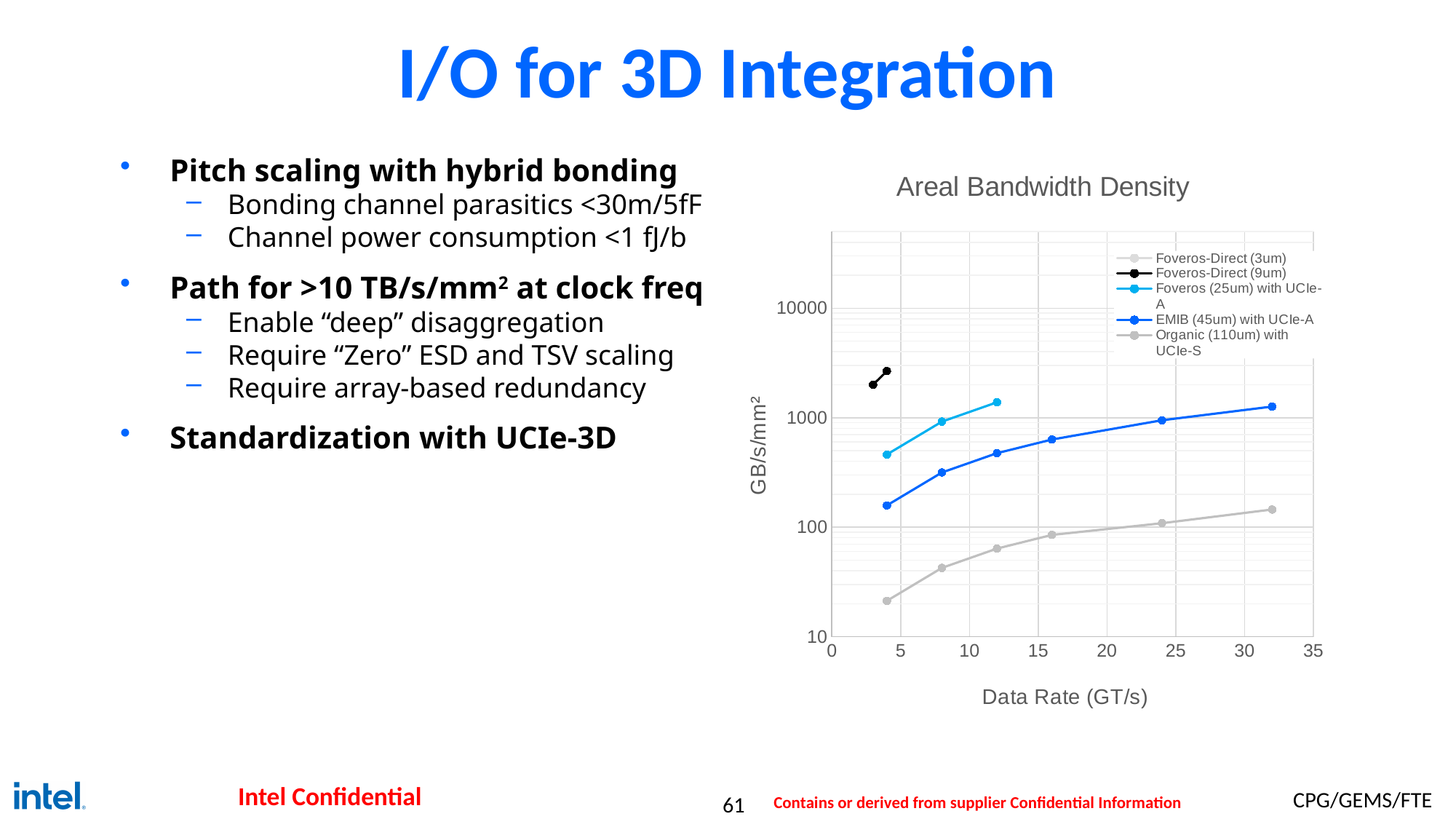
In the Areal Bandwidth Density chart, at 8 GT/s, which is larger: Foveros (25um) with UCIe-A or EMIB (45um) with UCIe-A? Foveros (25um) with UCIe-A In the Areal Bandwidth Density chart, is the value for Organic (110um) with UCIe-S at 32 GT/s greater or less than 100? greater What is the x-axis label of the Areal Bandwidth Density chart? Data Rate (GT/s) What is the title of the chart on the slide? Areal Bandwidth Density In the Areal Bandwidth Density chart, is the value for Organic (110um) with UCIe-S at 4 GT/s greater or less than 100? less In the Areal Bandwidth Density chart, is the value for EMIB (45um) with UCIe-A at 32 GT/s greater or less than 1000? greater In the Areal Bandwidth Density chart, which series has the lowest bandwidth density values? Organic (110um) with UCIe-S In the Areal Bandwidth Density chart, does the EMIB (45um) with UCIe-A series rise or fall as data rate increases? rise How many data points are plotted for the EMIB (45um) with UCIe-A series in the Areal Bandwidth Density chart? 6 How many series does the legend of the Areal Bandwidth Density chart list? 5 What kind of chart is the Areal Bandwidth Density chart? line chart